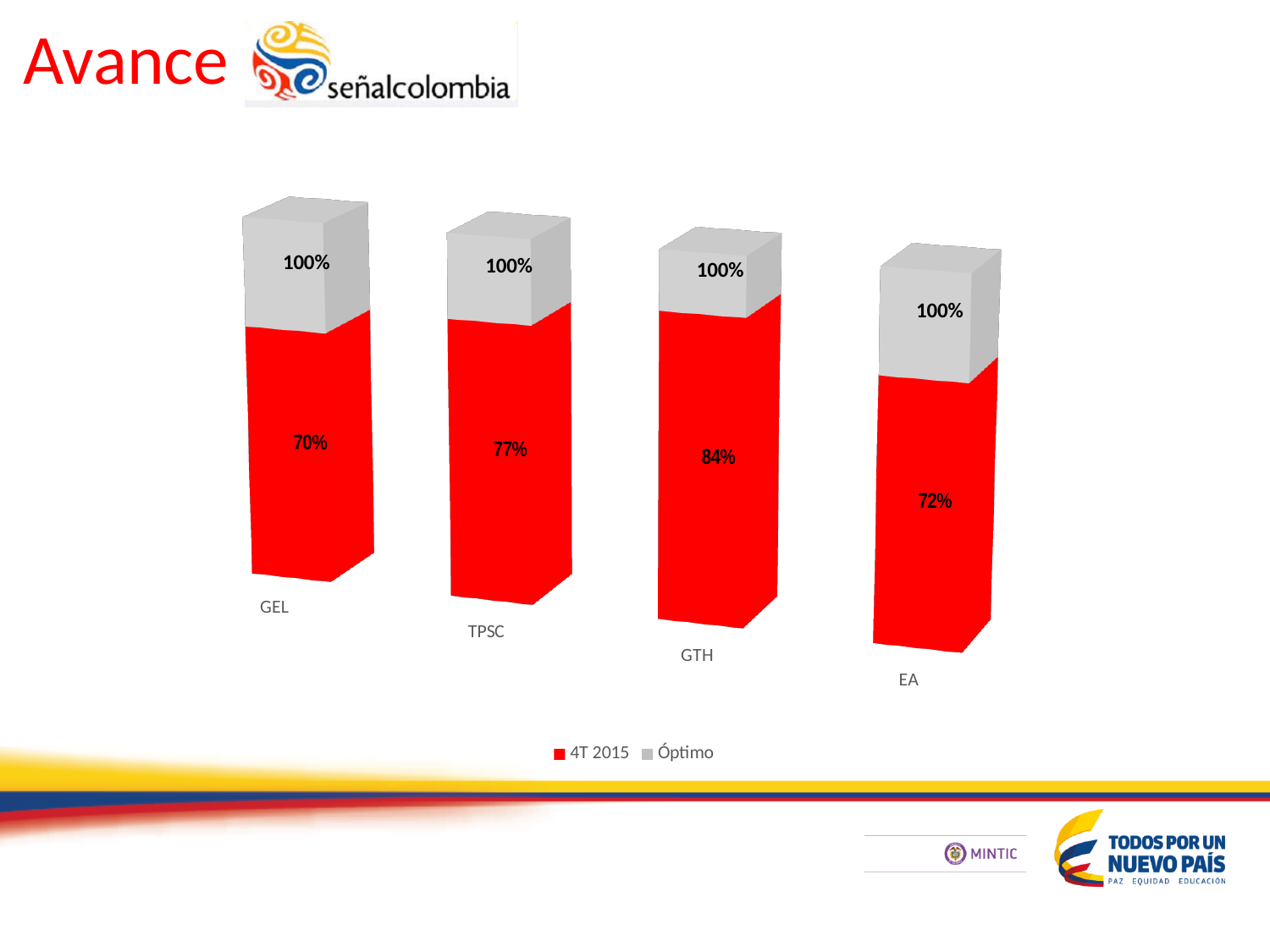
How many series does the legend list? 2 What is the 4T 2015 value for GTH? 84% What is the 4T 2015 value for TPSC? 77% What kind of chart is shown on the slide? Stacked bar chart What is the difference between the 4T 2015 values for GTH and GEL? 14% How many categories are shown on the x axis? 4 What is the Óptimo value shown for GTH? 100% What is the 4T 2015 value for GEL? 70% Which category has the highest 4T 2015 value? GTH What is the 4T 2015 value for EA? 72% Which has a larger 4T 2015 value, TPSC or EA? TPSC Which category has the lowest 4T 2015 value? GEL